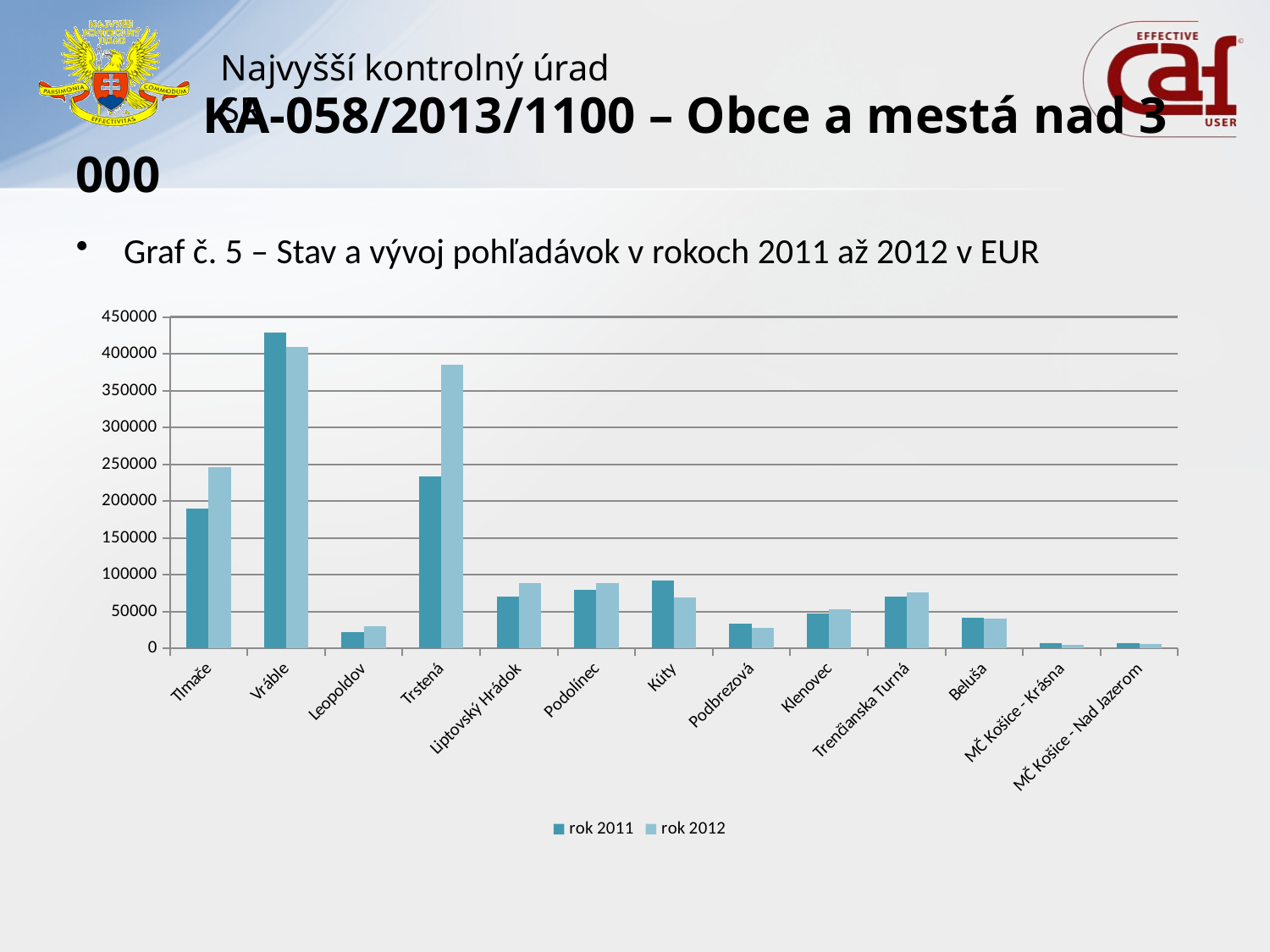
How many municipalities (categories) are shown on the x axis? 13 Is the rok 2012 value for Trstená greater or less than 350000? greater Is the rok 2011 value for Tlmače greater or less than 200000? less For Trstená, which is larger: the rok 2011 value or the rok 2012 value? rok 2012 For Kúty, which is larger: the rok 2011 value or the rok 2012 value? rok 2011 Which municipality has the highest value for rok 2012? Vráble What are the two series named in the legend? rok 2011 and rok 2012 Is the rok 2011 value for Vráble greater or less than 400000? greater What kind of chart is shown on the slide? bar chart How many series does the legend list? 2 Which municipality has the highest value for rok 2011? Vráble